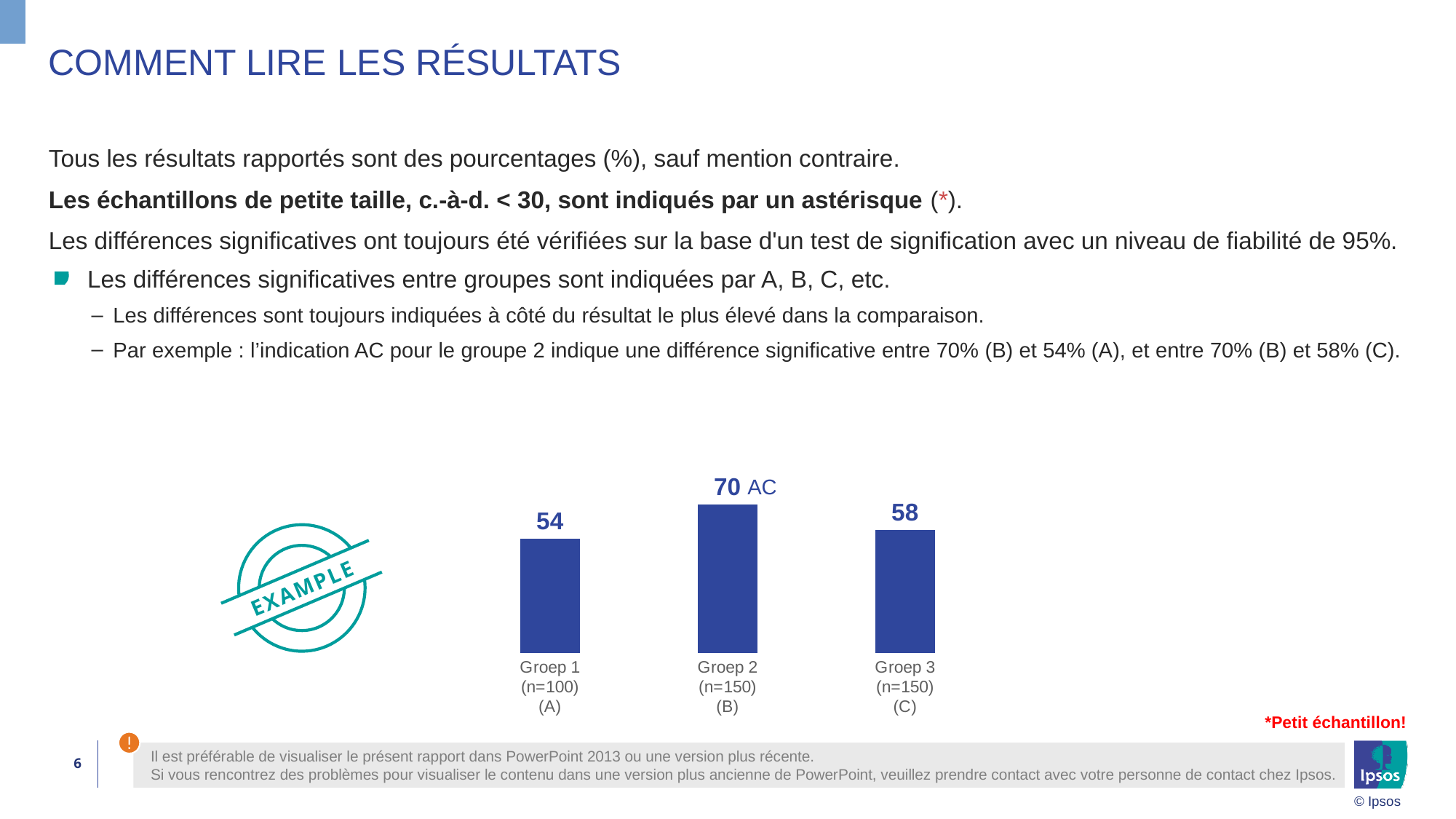
What is the value for Groep 3 (n=150) (C)? 58 What is the difference between the values for Groep 3 and Groep 1? 4 Which is larger, the value for Groep 2 or the value for Groep 3? Groep 2 Which significance letters are printed next to the value for Groep 2? AC How many groups are shown in the chart? 3 What is the value for Groep 2 (n=150) (B)? 70 What is the sample size (n) shown for Groep 1? n=100 Which group has the highest value? Groep 2 What is the difference between the values for Groep 2 and Groep 1? 16 Which group has the lowest value? Groep 1 What kind of chart is shown on the slide? bar chart What is the value for Groep 1 (n=100) (A)? 54